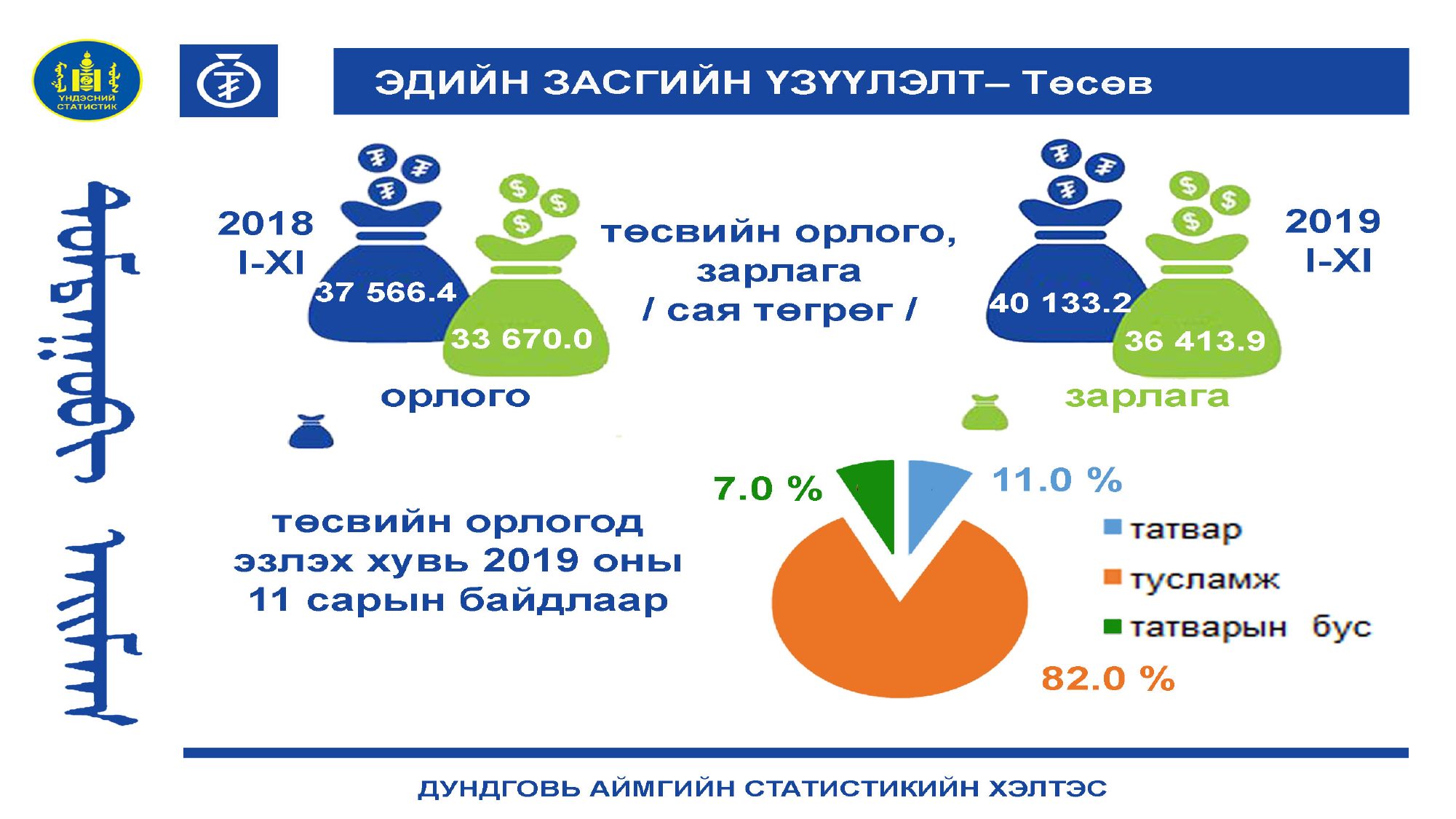
By how many percentage points does the тусламж slice exceed the татвар slice? 71.0 % How many entries does the pie chart legend list? 3 What is the difference between the татвар slice and the татварын бус slice? 4.0 % What colour is the тусламж slice in the pie chart? orange What share of the pie chart does татвар account for? 11.0 % What share of the pie chart does татварын бус account for? 7.0 % How many slices does the pie chart have? 3 What share of the pie chart does тусламж account for? 82.0 % Which category has the smallest slice in the pie chart? татварын бус What kind of chart is shown on the slide? pie chart Which category has the largest slice in the pie chart? тусламж Which slice is larger, татвар or татварын бус? татвар